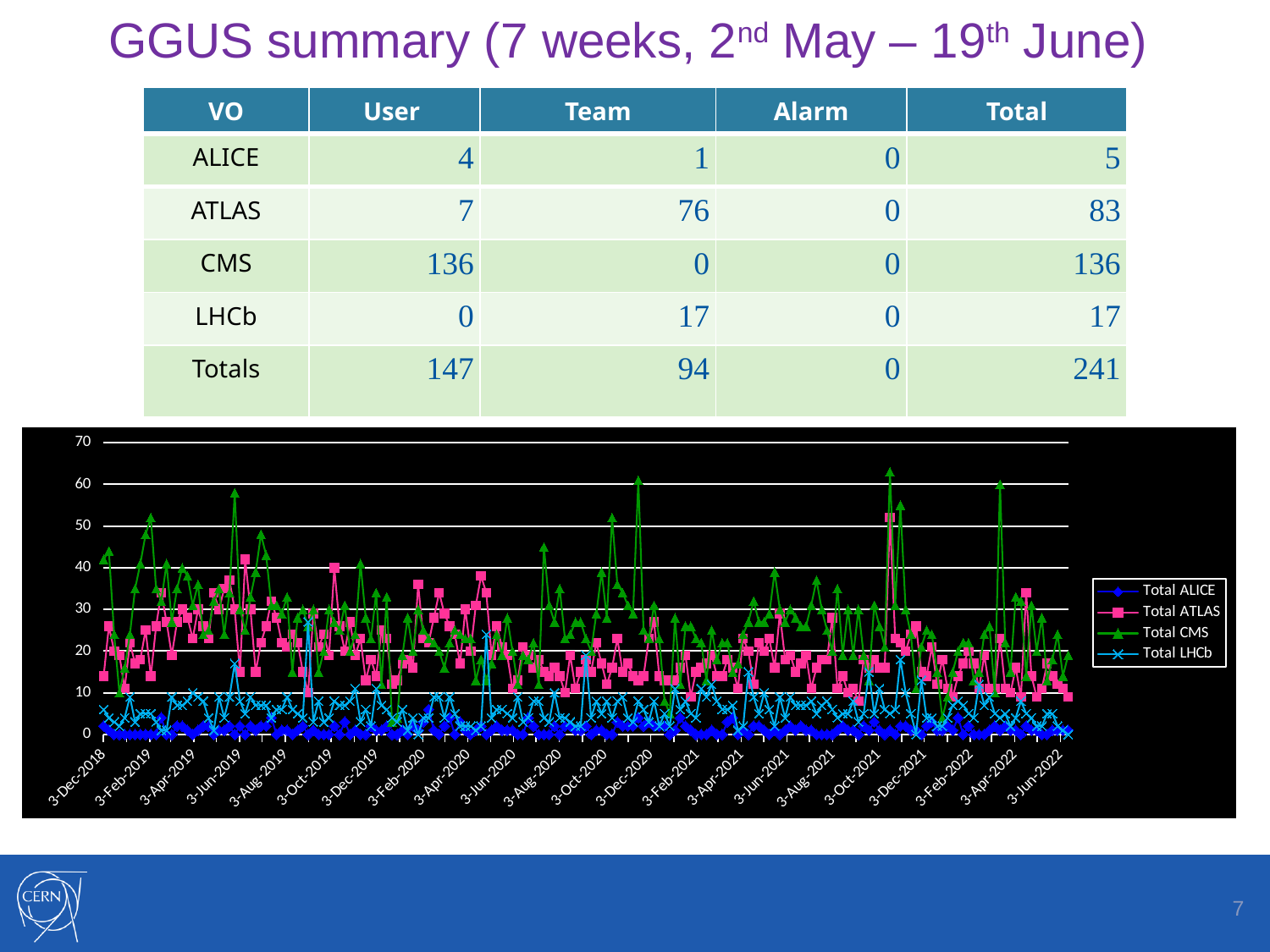
What is the first date label on the chart's x axis? 3-Dec-2018 Is the highest value reached by Total CMS greater or less than 50? greater Is the highest value reached by Total LHCb greater or less than 30? less How many date labels are shown along the chart's x axis? 22 Is the highest value reached by Total ALICE greater or less than 10? less What is the maximum value shown on the chart's y axis? 70 Which series in the chart stays lowest throughout the period? Total ALICE Which series generally has larger values, Total CMS or Total ALICE? Total CMS Which series in the chart reaches the highest peak value? Total CMS How many series does the chart's legend list? 4 What kind of chart is shown at the bottom of the slide? line chart